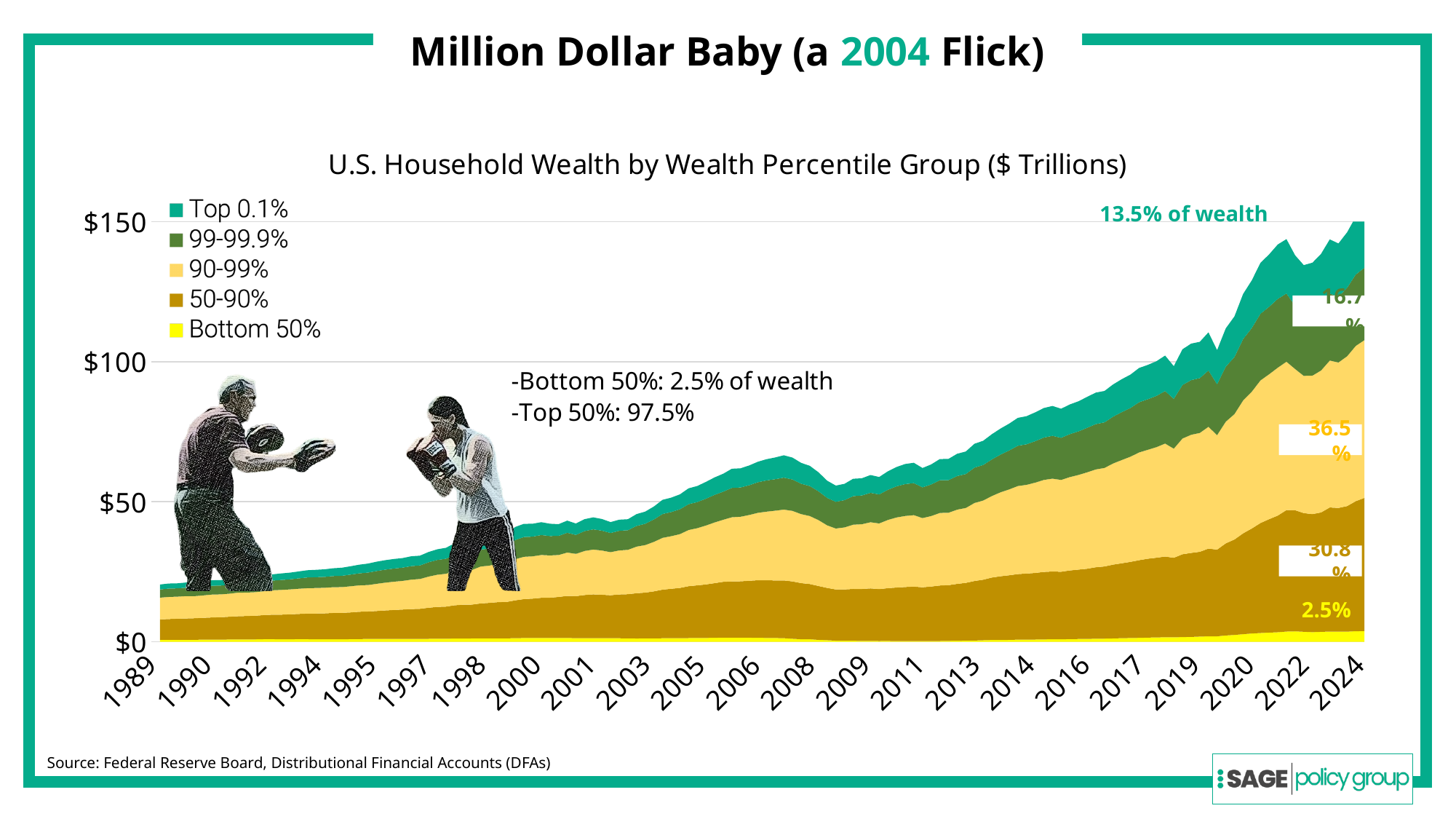
What is the title of the chart? U.S. Household Wealth by Wealth Percentile Group ($ Trillions) According to the annotation, what share of wealth does the 90-99% group hold? 36.5% Which group holds a larger share of wealth, the 90-99% group or the 50-90% group? 90-99% According to the annotation, what share of wealth does the Top 0.1% hold? 13.5% Is total household wealth in 2024 greater or less than $100 trillion? greater According to the text on the slide, what share of wealth does the Top 50% hold? 97.5% How many series does the chart legend list? 5 What kind of chart is shown on the slide? Stacked area chart According to the annotation, what share of wealth does the 50-90% group hold? 30.8% What is the difference in percentage points between the 90-99% group's share (36.5%) and the 50-90% group's share (30.8%)? 5.7 percentage points According to the annotation, what share of wealth does the Bottom 50% hold? 2.5% Does total household wealth generally rise or fall from 1989 to 2024? Rise